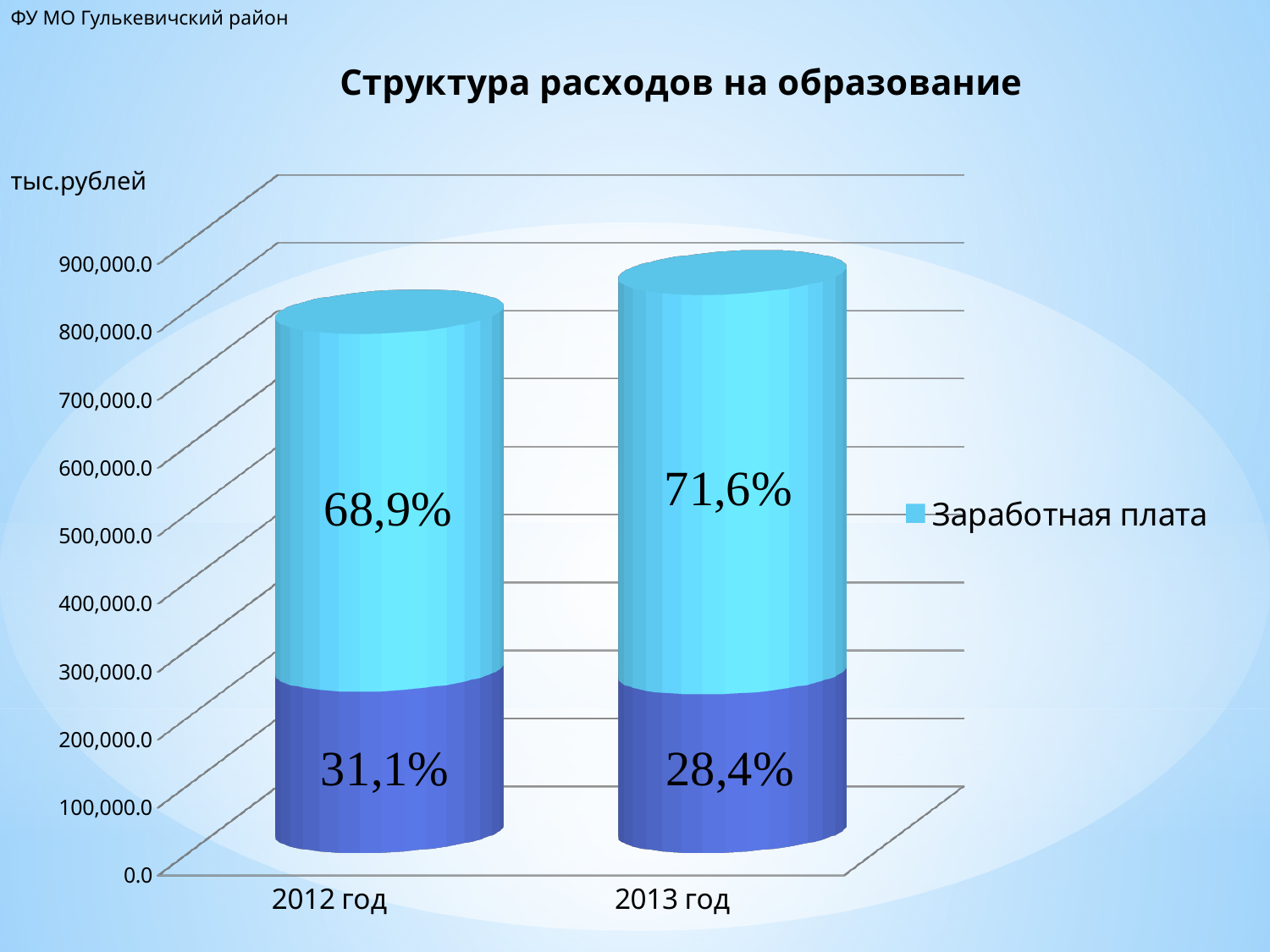
Is the total height of the 2012 год bar greater or less than 500,000.0? greater In which year is the share of Заработная плата higher, 2012 год or 2013 год? 2013 год What is the difference between the lower segment shares of 2012 год (31,1%) and 2013 год (28,4%)? 2,7% What percentage is printed on the lower (dark blue) segment of the 2013 год bar? 28,4% What is the share of Заработная плата in 2013 год? 71,6% What percentage is printed on the lower (dark blue) segment of the 2012 год bar? 31,1% How many years (categories) are shown on the x axis? 2 What kind of chart is shown on the slide? Stacked bar chart Does the share of Заработная плата rise or fall from 2012 год to 2013 год? Rises What is the title of the chart? Структура расходов на образование By how many percentage points did the share of Заработная плата change from 2012 год to 2013 год? 2,7% What is the share of Заработная плата in 2012 год? 68,9%